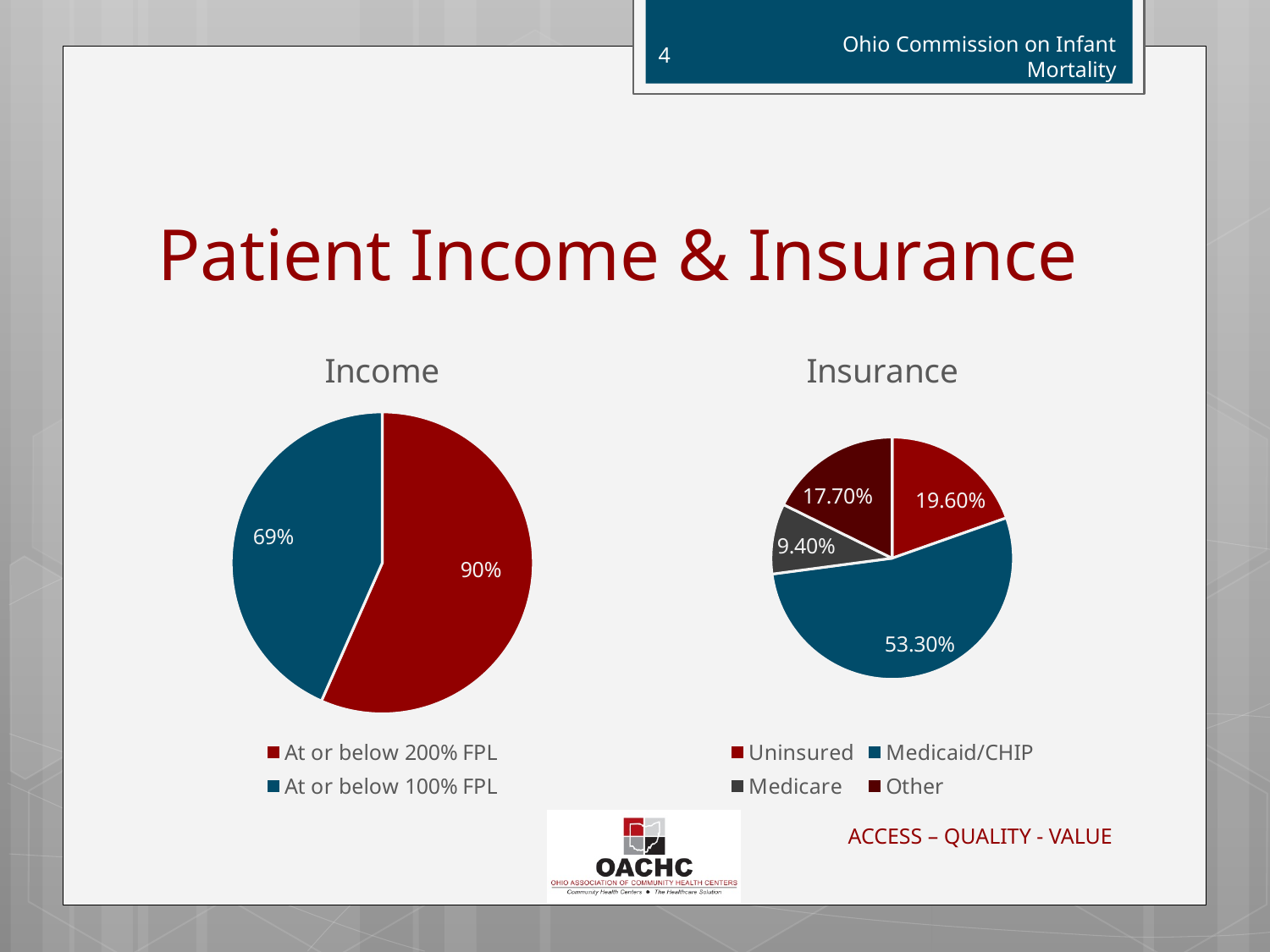
In the Income chart, which category has the larger value? At or below 200% FPL In the Insurance chart, which category has the smallest share? Medicare In the Insurance chart, which is larger, Uninsured or Other? Uninsured In the Insurance chart, what share is Medicaid/CHIP? 53.30% In the Insurance chart, what share is Uninsured? 19.60% In the Insurance chart, what share is Medicare? 9.40% How many categories does the Insurance chart's legend list? 4 In the Income chart, what value is shown for At or below 100% FPL? 69% In the Insurance chart, what is the difference between the Medicaid/CHIP share and the Uninsured share? 33.70 percentage points In the Income chart, what value is shown for At or below 200% FPL? 90% In the Income chart, what is the difference between the At or below 200% FPL value and the At or below 100% FPL value? 21 percentage points What kind of chart is the Income chart? pie chart